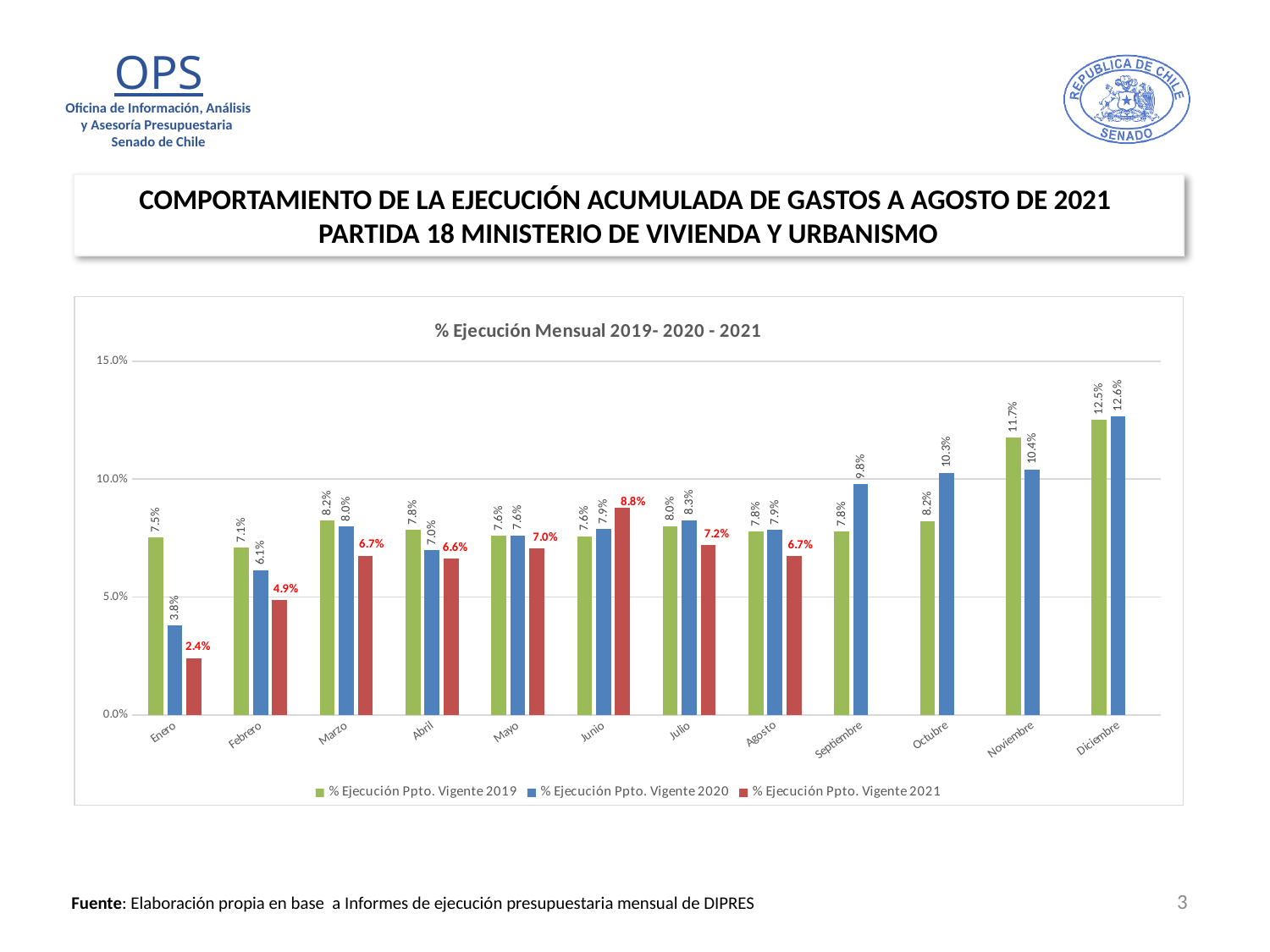
How many months are shown on the x axis? 12 What is the value for % Ejecución Ppto. Vigente 2020 in Septiembre? 9.8% What is the value for % Ejecución Ppto. Vigente 2021 in Enero? 2.4% Which is larger in Junio: the 2019 value or the 2021 value? The 2021 value What is the title of the chart? % Ejecución Mensual 2019- 2020 - 2021 Is the value for % Ejecución Ppto. Vigente 2020 in Diciembre greater or less than 10.0%? greater In which month is the % Ejecución Ppto. Vigente 2020 series lowest? Enero What is the value for % Ejecución Ppto. Vigente 2019 in Noviembre? 11.7% What is the difference between the 2019 and 2021 values in Enero? 5.1% What kind of chart is shown on the slide? Bar chart In which month is the % Ejecución Ppto. Vigente 2021 series highest? Junio How many series does the legend list? 3